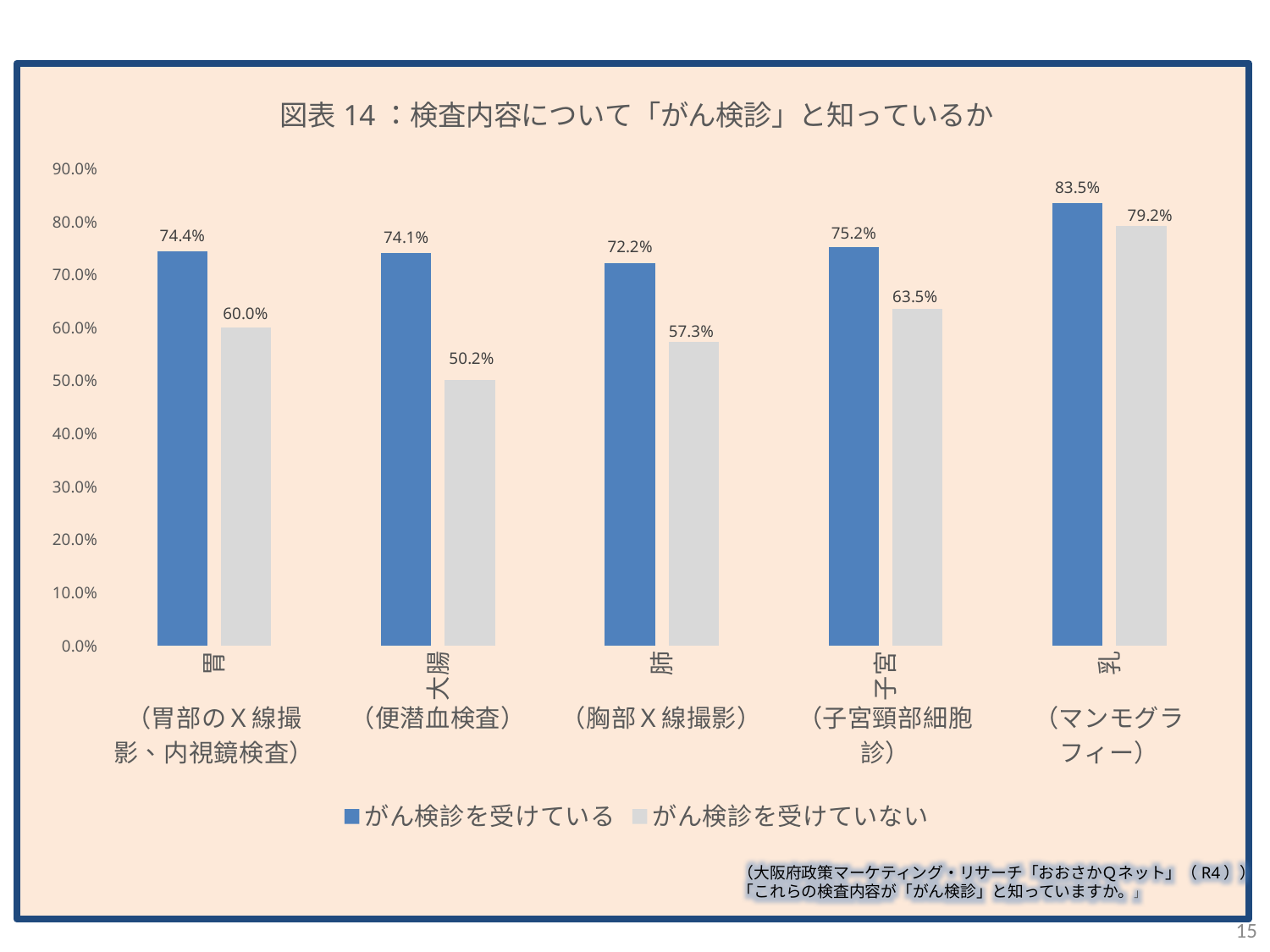
What is the value for がん検診を受けていない in the （マンモグラフィー） category? 79.2% What is the difference between がん検診を受けている and がん検診を受けていない in the （子宮頸部細胞診） category? 11.7% How many categories are shown on the x axis? 5 What is the value for がん検診を受けていない in the （胸部Ｘ線撮影） category? 57.3% Is the value for がん検診を受けていない in the （便潜血検査） category greater or less than 60.0%? less What kind of chart is shown on the slide? bar chart In the （胃部のＸ線撮影、内視鏡検査） category, which series has the larger value, がん検診を受けている or がん検診を受けていない? がん検診を受けている What is the value for がん検診を受けている in the （便潜血検査） category? 74.1% What is the title of the chart? 図表 14：検査内容について「がん検診」と知っているか How many series does the legend list? 2 Which category has the lowest value for がん検診を受けていない? （便潜血検査） Which category has the highest value for がん検診を受けている? （マンモグラフィー）